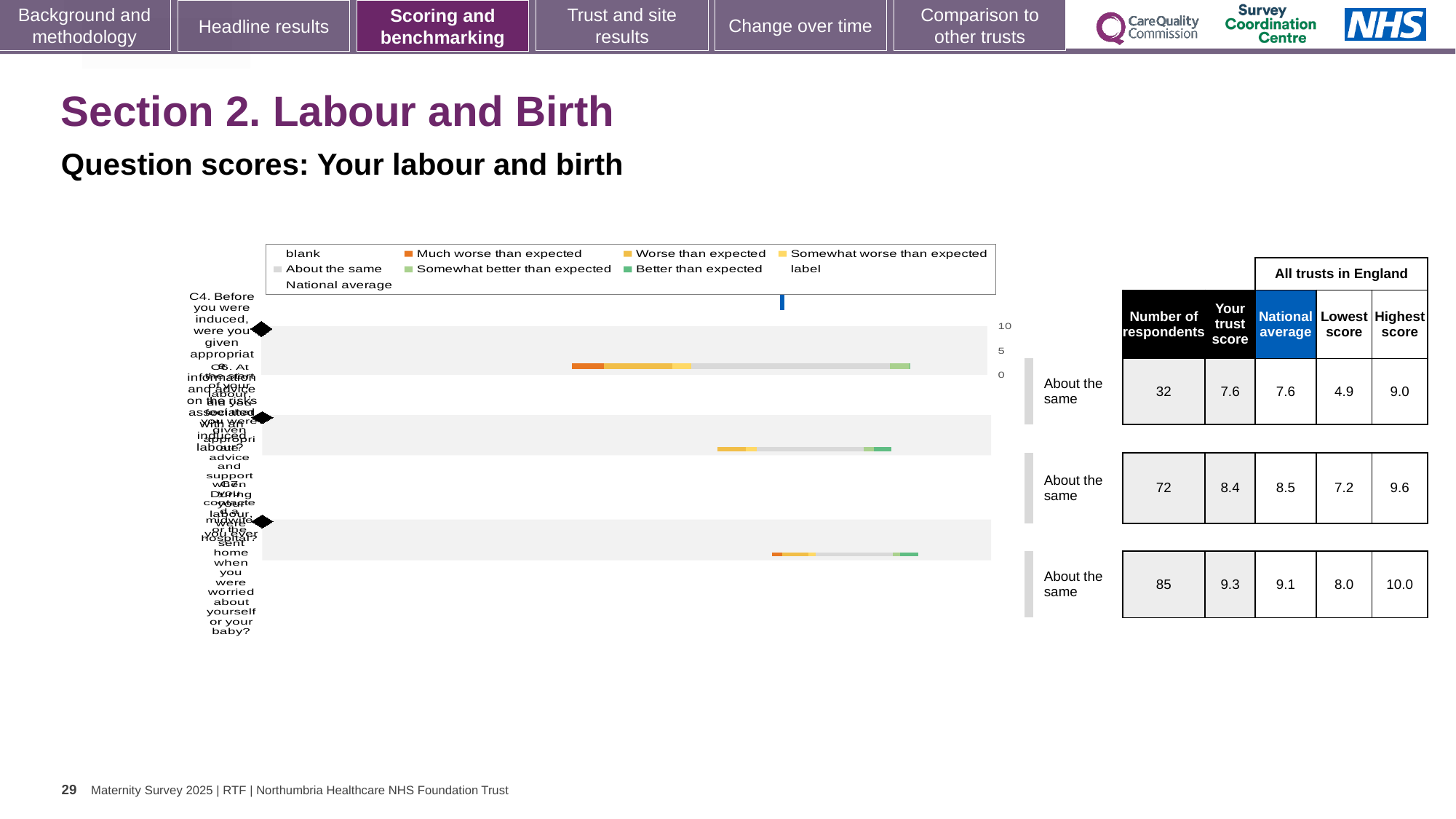
Which question row has the highest 'Your trust score' in the table beside the chart? the third (bottom) row, 9.3 What kind of chart is shown on the slide? bar chart In the table beside the chart, what is the number of respondents for the first (top) question row? 32 For the third question row, what is the difference between the highest score and the lowest score in the table? 2.0 How many question rows (bars) are plotted in the chart? 3 What benchmark category is shown for each of the three question rows? About the same In the table beside the chart, what is the national average for the third (bottom) question row? 9.1 For the second question row, which is larger: 'Your trust score' or the national average? national average In the table beside the chart, what is 'Your trust score' for the second question row? 8.4 In the chart legend, what colour represents 'Much worse than expected'? orange In the chart legend, what colour represents 'Better than expected'? green Which question row has the lowest 'Lowest score' value in the table beside the chart? the first (top) row, 4.9